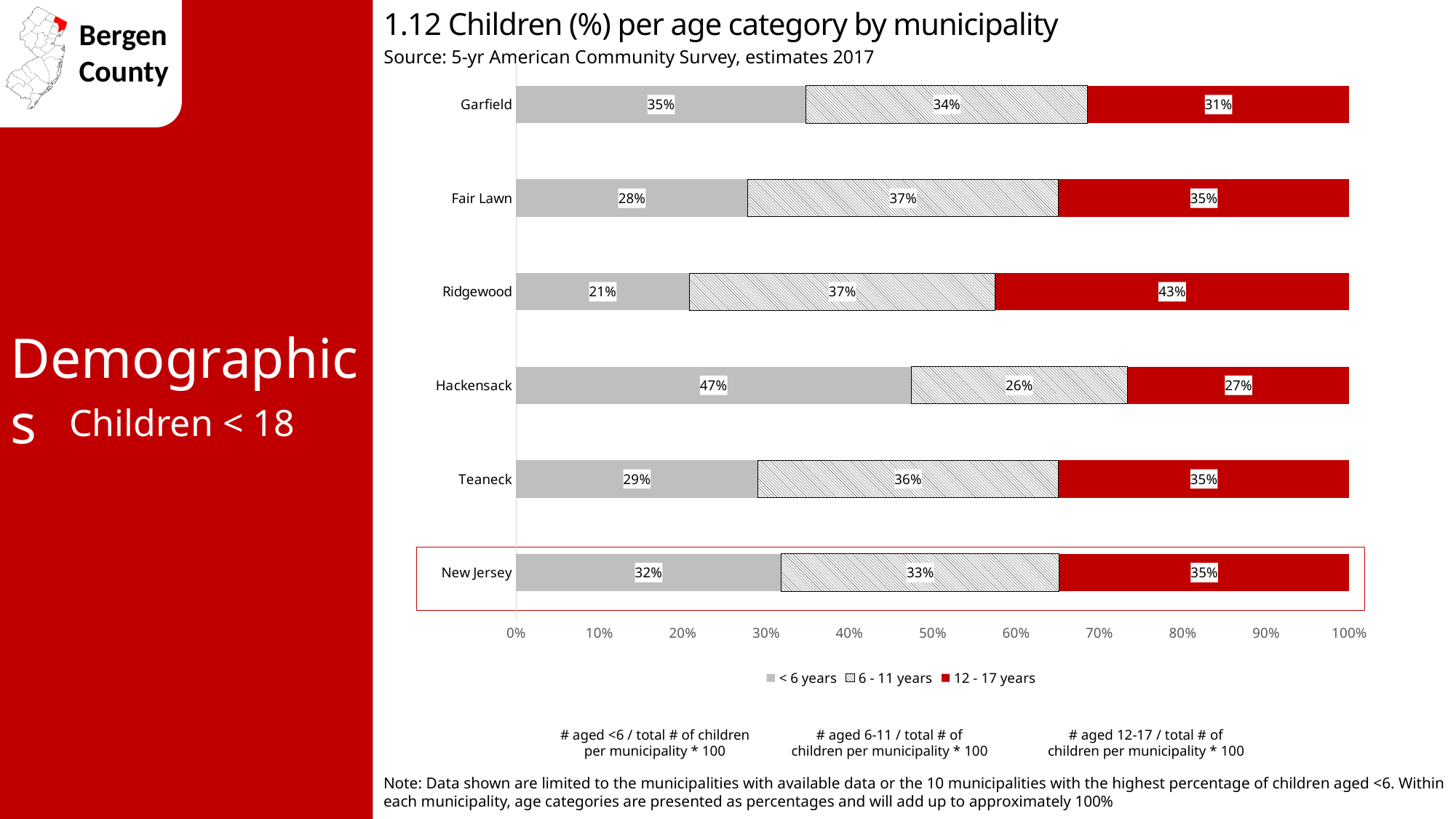
Which municipality has the lowest percentage of children under 6 years? Ridgewood How many municipalities (including New Jersey) are shown on the chart? 6 What is the value for the 12 - 17 years category in Ridgewood? 43% What is the difference between the < 6 years percentage in Hackensack and in Ridgewood? 26 percentage points Which is larger: the 6 - 11 years share in Garfield or in Hackensack? Garfield What percentage of children in Fair Lawn are aged 6 - 11 years? 37% What kind of chart is shown on the slide? Stacked bar chart Which municipality has the highest percentage of children under 6 years? Hackensack What percentage of children in Hackensack are under 6 years old? 47% Which municipality has the highest percentage of children aged 12 - 17 years? Ridgewood What is the value for the < 6 years category for New Jersey? 32% How many series does the legend list? 3